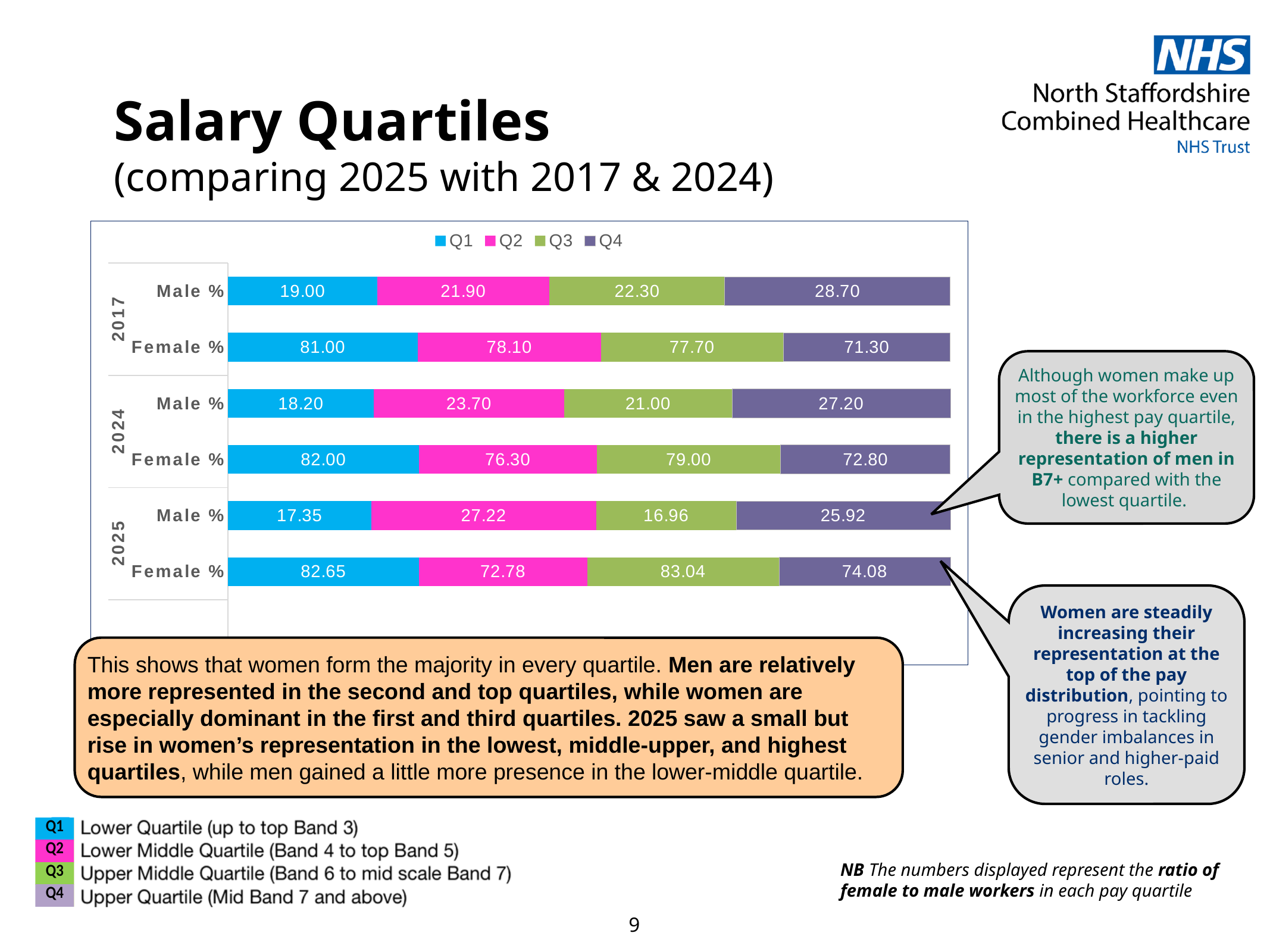
What is the Q4 value for Female % in 2017? 71.30 Which year has the highest Q1 value for Female %? 2025 Which is larger, the Q2 value for Male % in 2025 or in 2024? 2025 What is the difference between the Q4 values for Female % and Male % in 2024? 45.60 Which year has the lowest Q3 value for Male %? 2025 What kind of chart is shown on the slide? Stacked bar chart How many series does the legend list? 4 What is the difference between the Q1 values for Female % and Male % in 2025? 65.30 How many bars are plotted in the chart? 6 What is the Q2 value for Male % in 2025? 27.22 What is the Q3 value for Male % in 2024? 21.00 What colour represents Q2 in the chart? Pink